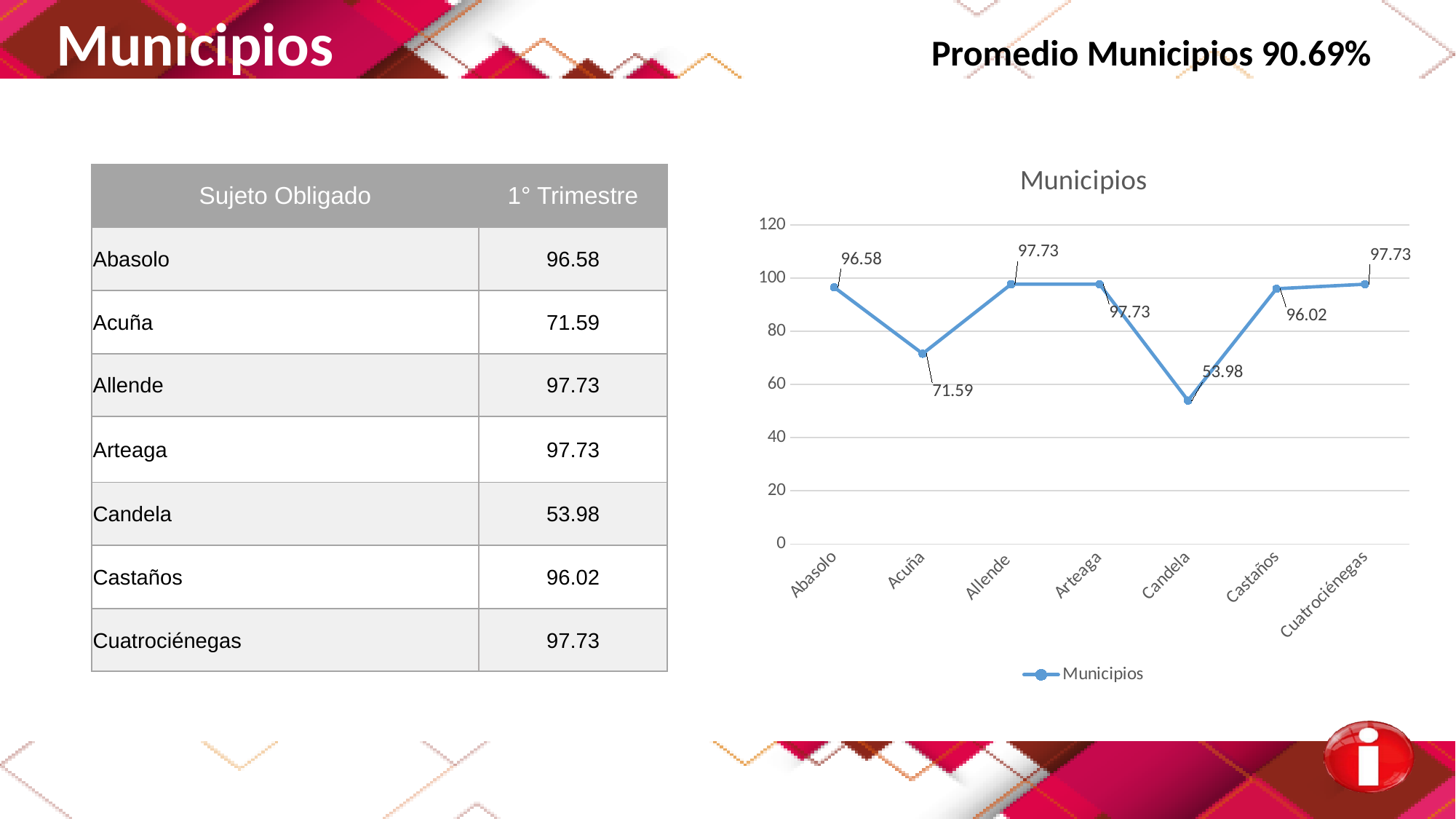
Which is larger in the Municipios chart, the value for Castaños or the value for Candela? Castaños How many categories are plotted on the x axis of the Municipios chart? 7 How many series does the legend of the Municipios chart list? 1 Which category has the lowest value in the Municipios chart? Candela What is the value for Acuña in the Municipios chart? 71.59 What is the value for Candela in the Municipios chart? 53.98 What is the value for Castaños in the Municipios chart? 96.02 Is the value for Acuña in the Municipios chart greater or less than 80? less What is the difference between the values for Abasolo and Acuña in the Municipios chart? 24.99 What kind of chart is the Municipios chart? line chart What is the title of the chart on the slide? Municipios What is the difference between the values for Allende and Candela in the Municipios chart? 43.75